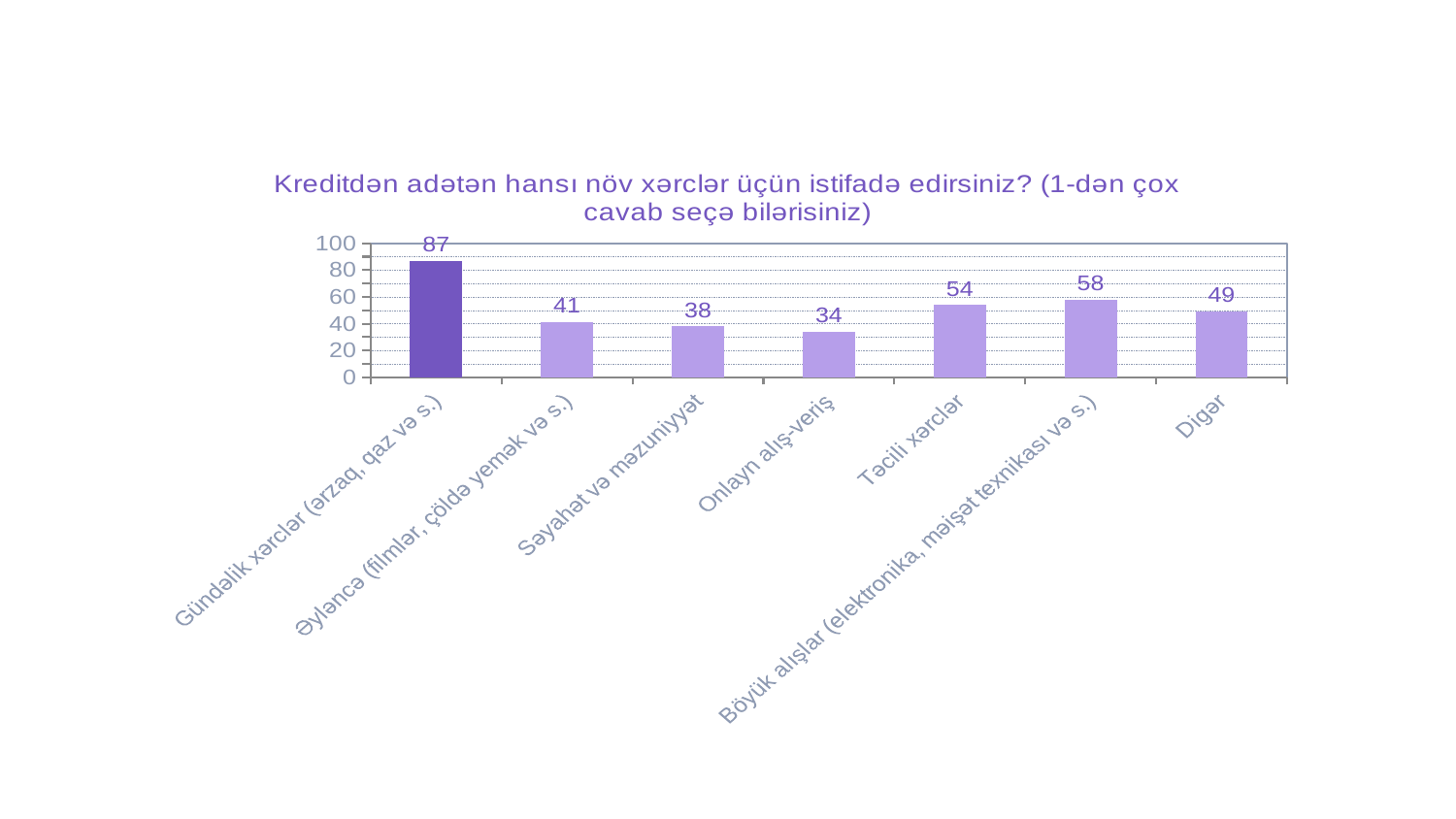
What is the value for Onlayn alış-veriş? 34 How many categories are shown on the chart? 7 Is the value for Böyük alışlar (elektronika, məişət texnikası və s.) greater or less than 40? greater Which category has the lowest value? Onlayn alış-veriş What is the title of the chart? Kreditdən adətən hansı növ xərclər üçün istifadə edirsiniz? (1-dən çox cavab seçə bilərisiniz) What is the value for Digər? 49 Which category has the highest value? Gündəlik xərclər (ərzaq, qaz və s.) What is the difference between the values for Gündəlik xərclər (ərzaq, qaz və s.) and Böyük alışlar (elektronika, məişət texnikası və s.)? 29 What is the value for Təcili xərclər? 54 Which is larger: the value for Əyləncə (filmlər, çöldə yemək və s.) or the value for Səyahət və məzuniyyət? Əyləncə (filmlər, çöldə yemək və s.) What is the value for Gündəlik xərclər (ərzaq, qaz və s.)? 87 What kind of chart is shown on the slide? bar chart